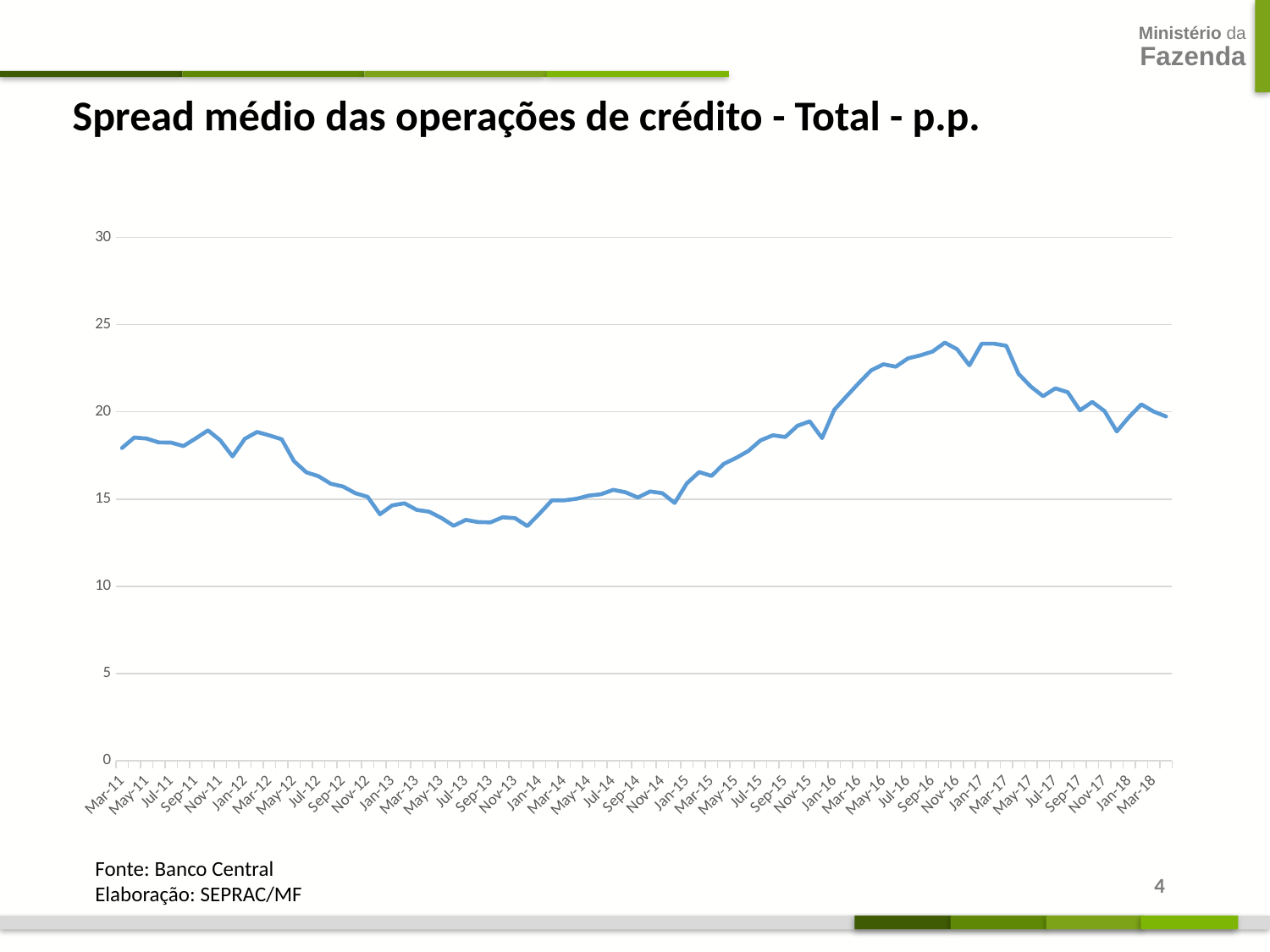
What is the source cited below the chart? Banco Central What kind of chart is shown on the slide? line chart Is the value for Jul-13 greater or less than 15? less Does the line rise or fall between Mar-11 and Jul-13? fall Is the value for Sep-16 greater or less than 20? greater What is the title of the chart? Spread médio das operações de crédito - Total - p.p. Is the value for Jan-13 greater or less than 15? less Which is larger, the value for Nov-16 or the value for Jul-13? Nov-16 Does the line rise or fall between Nov-13 and Nov-16? rise